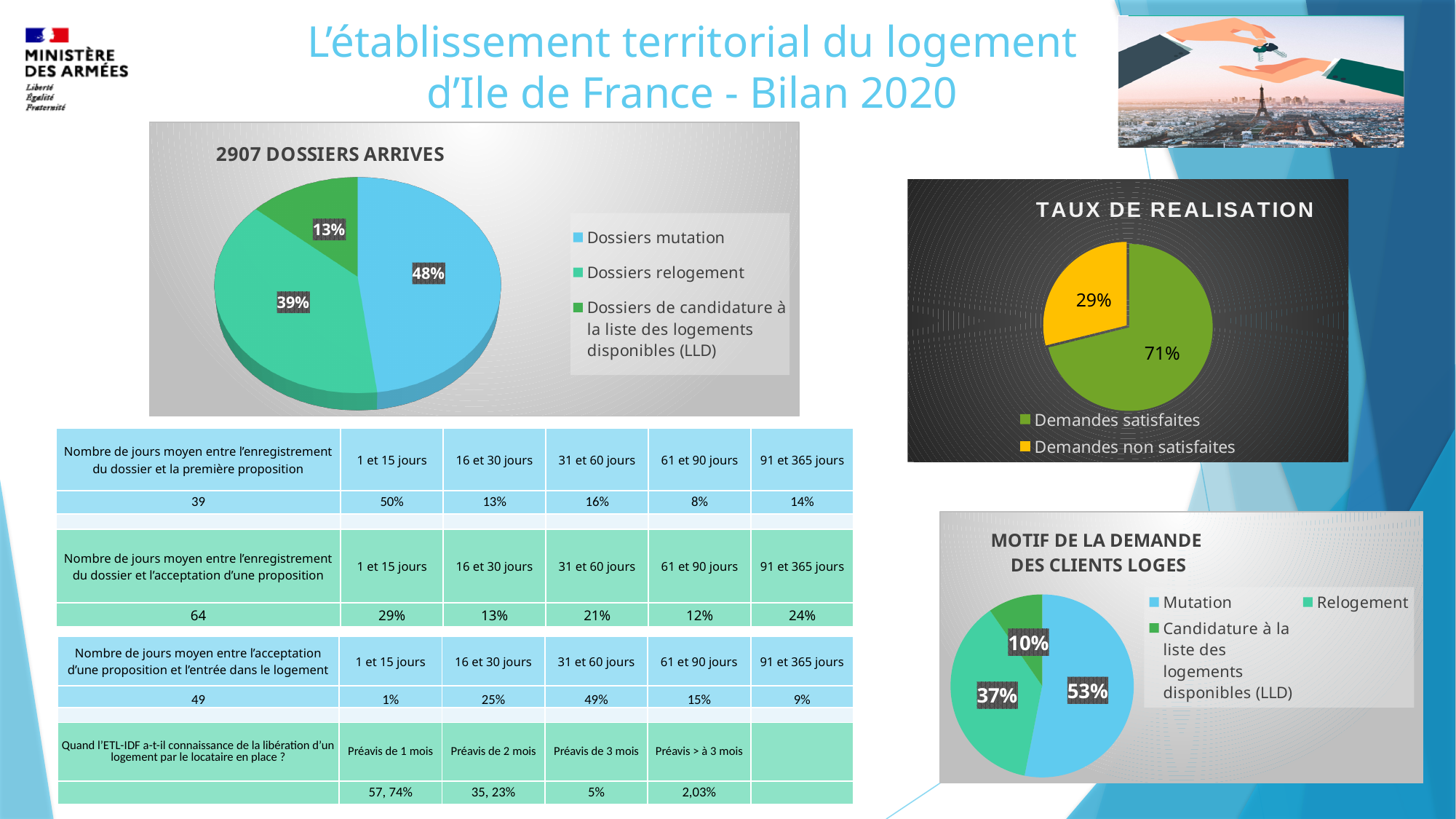
In the 'MOTIF DE LA DEMANDE DES CLIENTS LOGES' chart, what share is Mutation? 53% What kind of chart is 'TAUX DE REALISATION'? Pie chart In the 'TAUX DE REALISATION' chart, what share is Demandes non satisfaites? 29% In the '2907 DOSSIERS ARRIVES' chart, what is the difference in percentage points between Dossiers mutation and Dossiers relogement? 9 In the 'MOTIF DE LA DEMANDE DES CLIENTS LOGES' chart, which category has the largest slice? Mutation In the '2907 DOSSIERS ARRIVES' chart, what share is Dossiers mutation? 48% How many categories does the '2907 DOSSIERS ARRIVES' chart show? 3 How many entries does the legend of the 'MOTIF DE LA DEMANDE DES CLIENTS LOGES' chart list? 3 In the '2907 DOSSIERS ARRIVES' chart, which category has the smallest slice? Dossiers de candidature à la liste des logements disponibles (LLD) In the 'MOTIF DE LA DEMANDE DES CLIENTS LOGES' chart, which is larger, Relogement or Candidature à la liste des logements disponibles (LLD)? Relogement In the 'TAUX DE REALISATION' chart, what share is Demandes satisfaites? 71% In the '2907 DOSSIERS ARRIVES' chart, what share is Dossiers relogement? 39%